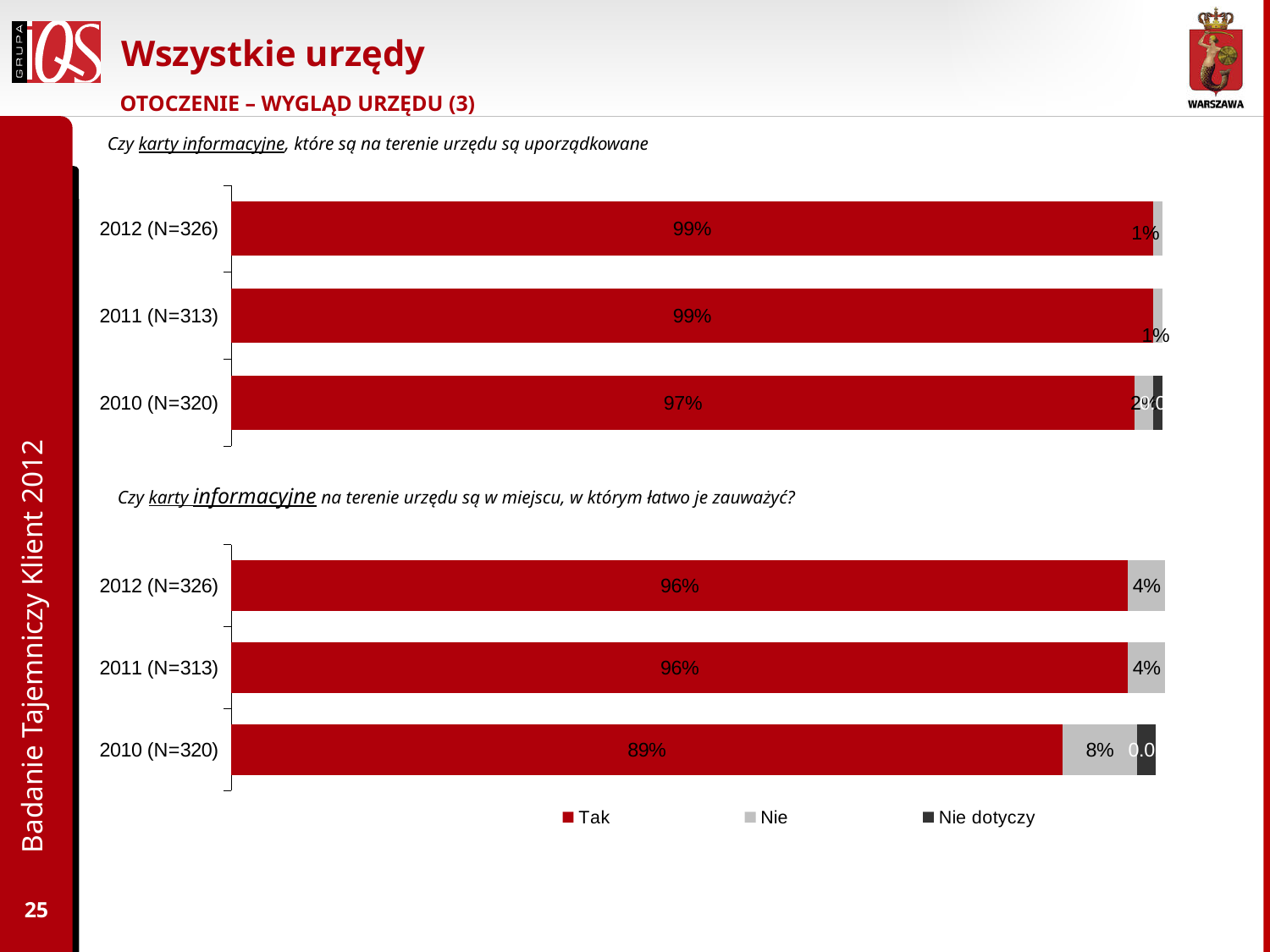
In the top chart, what is the 'Tak' value for 2010 (N=320)? 97% In the top chart, what is the 'Tak' value for 2012 (N=326)? 99% How many series does the legend list? 3 How many year categories are shown in the bottom chart? 3 In the top chart, which is larger: the 'Nie' value for 2010 (N=320) or for 2012 (N=326)? 2010 (N=320) In the bottom chart, what is the 'Nie' value for 2012 (N=326)? 4% In the bottom chart, which year has the lowest 'Tak' value? 2010 (N=320) In the top chart, what is the 'Nie' value for 2010 (N=320)? 2% In the bottom chart, what is the 'Nie' value for 2010 (N=320)? 8% In the bottom chart, what is the difference between the 'Tak' values for 2012 (N=326) and 2010 (N=320)? 7% In the bottom chart, what is the 'Tak' value for 2010 (N=320)? 89% What type of chart is the top chart? Stacked bar chart